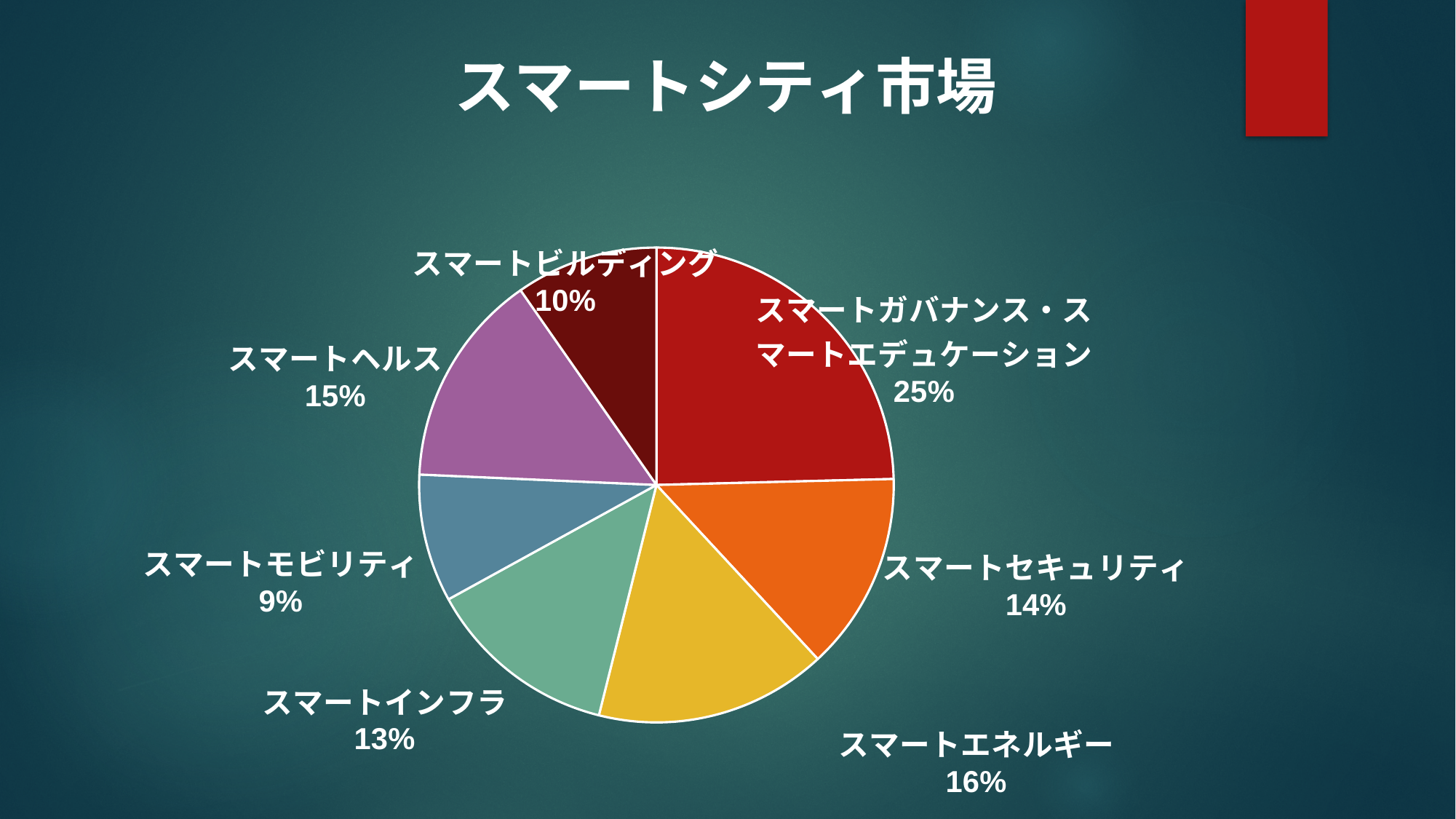
What share does スマートビルディング have? 10% What share does スマートエネルギー have? 16% What share does スマートガバナンス・スマートエデュケーション have? 25% What is the difference between the shares of スマートヘルス and スマートインフラ? 2% What is the title of the chart? スマートシティ市場 Which category has the largest share of the pie? スマートガバナンス・スマートエデュケーション Which category has the smallest share of the pie? スマートモビリティ How many categories are shown in the pie chart? 7 What share does スマートモビリティ have? 9% Which is larger, the share of スマートセキュリティ or the share of スマートエネルギー? スマートエネルギー What colour is the slice for スマートヘルス? Purple What kind of chart is shown on the slide? Pie chart